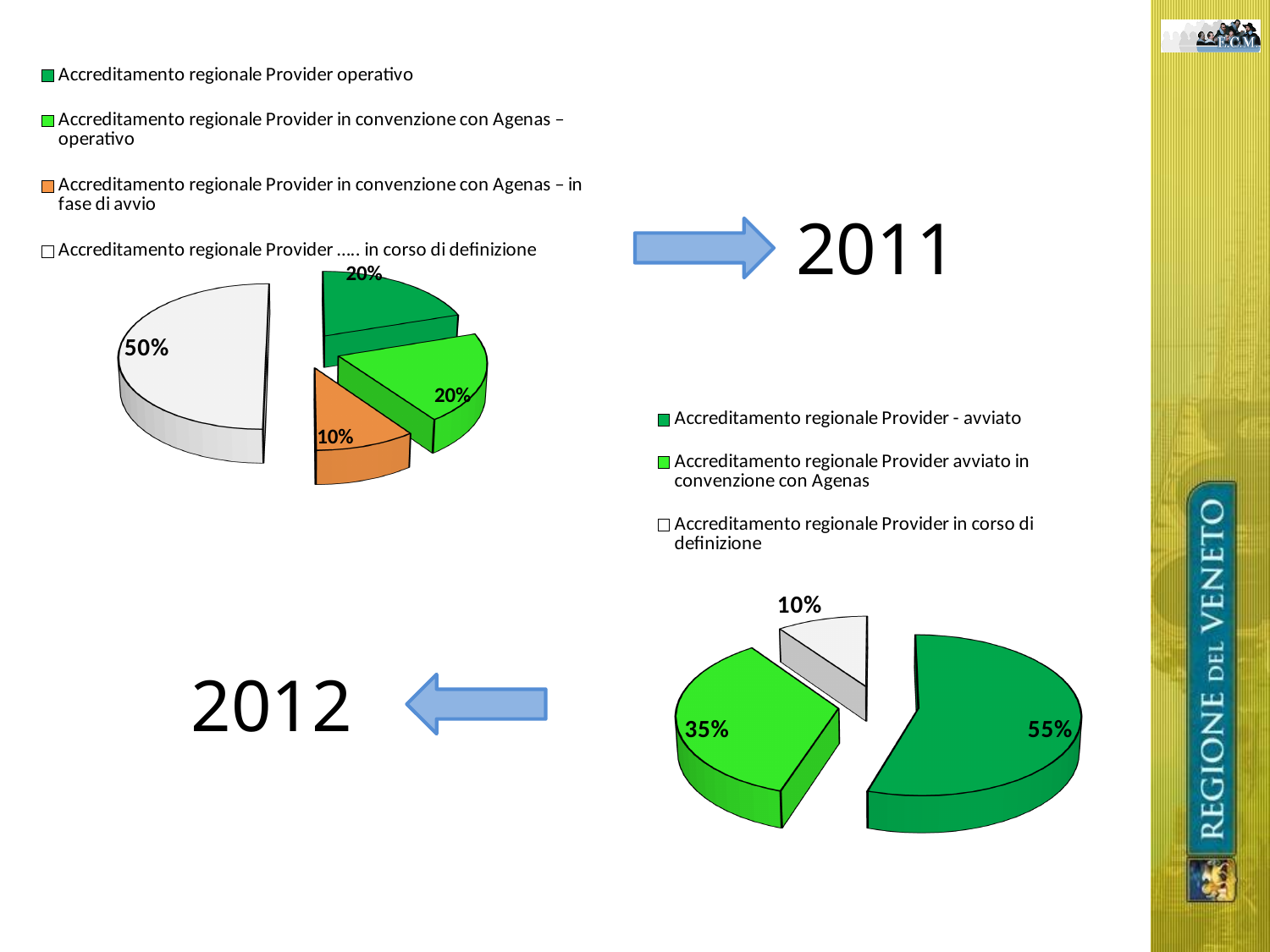
What kind of chart is the top-left chart on the slide? pie chart In the top-left pie chart, which category has the smallest share? Accreditamento regionale Provider in convenzione con Agenas – in fase di avvio In the bottom-right pie chart, which category has the smallest share? Accreditamento regionale Provider in corso di definizione How many slices does the top-left pie chart have? 4 In the bottom-right pie chart, what share is shown for Accreditamento regionale Provider avviato in convenzione con Agenas? 35% In the bottom-right pie chart, what share is shown for Accreditamento regionale Provider - avviato? 55% In the top-left pie chart, which category has the largest share? Accreditamento regionale Provider ..... in corso di definizione In the top-left pie chart, what is the difference between the 50% slice and the 10% slice? 40% In the top-left pie chart, what share is shown for the orange slice (Accreditamento regionale Provider in convenzione con Agenas – in fase di avvio)? 10% In the top-left pie chart, what share is labelled for the white slice (Accreditamento regionale Provider ..... in corso di definizione)? 50% In the bottom-right pie chart, what is the difference between the 55% slice and the 35% slice? 20% How many entries does the legend of the bottom-right pie chart list? 3